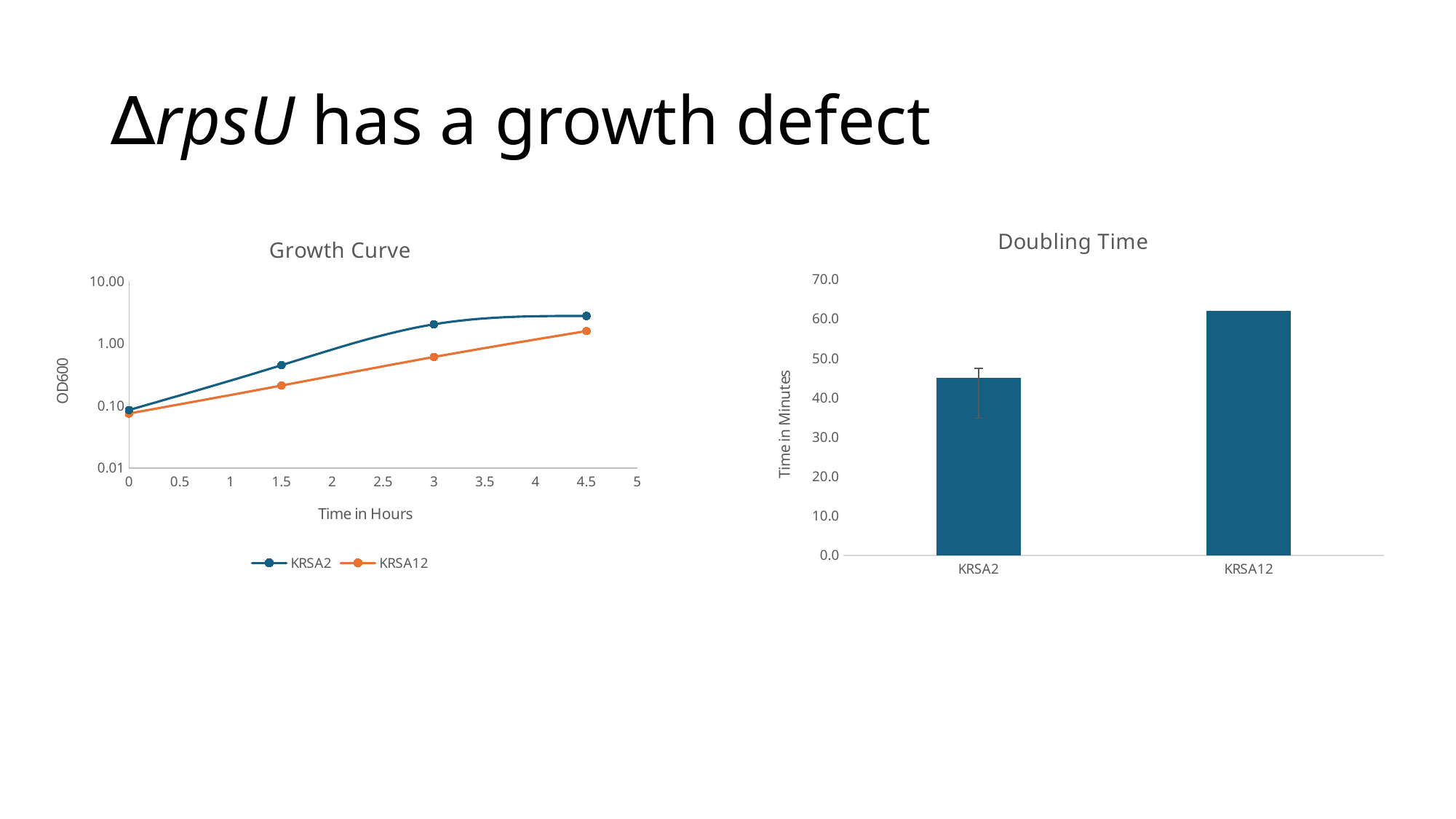
How many bars are shown in the Doubling Time chart? 2 In the Doubling Time chart, is the value for KRSA2 greater or less than 50.0? less In the Doubling Time chart, is the value for KRSA2 greater or less than 40.0? greater How many series does the legend of the Growth Curve chart list? 2 What kind of chart is the Growth Curve chart? line chart What kind of chart is the Doubling Time chart? bar chart In the Growth Curve chart, is the OD600 value for KRSA12 at 1.5 hours greater or less than 1.00? less In the Doubling Time chart, which strain has the lower doubling time? KRSA2 In the Growth Curve chart, which series has the higher OD600 at 3 hours, KRSA2 or KRSA12? KRSA2 In the Doubling Time chart, which strain has the higher doubling time? KRSA12